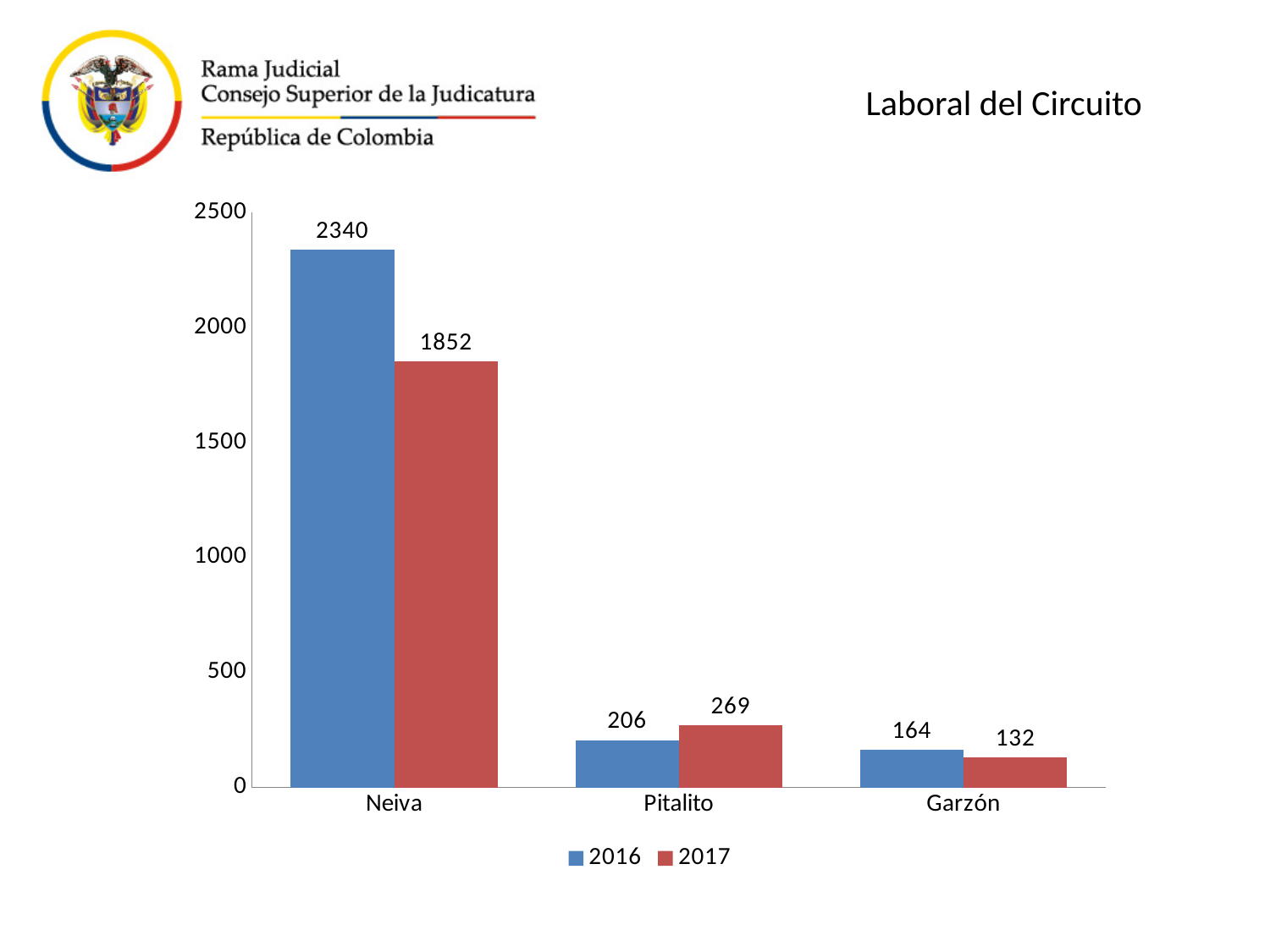
What is the value for Garzón in 2017? 132 Which category has the highest value for 2017? Neiva What is the difference between the 2016 and 2017 values for Neiva? 488 What kind of chart is shown on the slide? bar chart Which is larger for Pitalito, the 2016 value or the 2017 value? 2017 What is the title shown on the slide for the chart? Laboral del Circuito How many series does the legend list? 2 How many categories are shown on the x axis? 3 Is the 2017 value for Neiva greater or less than 2000? less What is the value for Neiva in 2016? 2340 What is the value for Pitalito in 2017? 269 Which category has the lowest value for 2016? Garzón